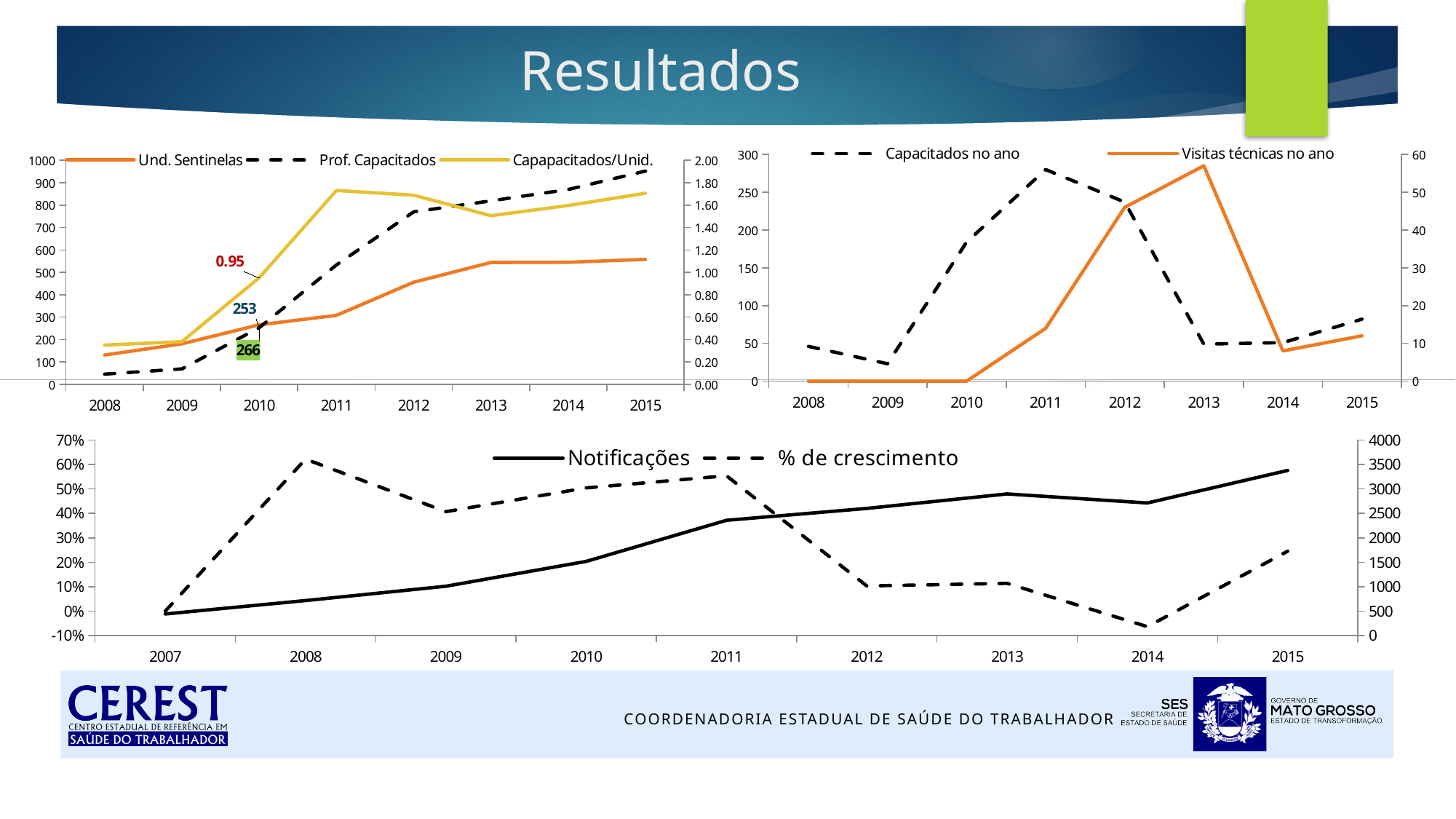
How many series does the legend of the top-left chart list? 3 How many years are shown on the x axis of the bottom chart? 9 In the top-right chart, in which year does Capacitados no ano reach its highest value? 2011 How many series does the legend of the top-right chart list? 2 In the top-right chart, in which year does Visitas técnicas no ano reach its highest value? 2013 In the top-left chart, what value is labelled for Capapacitados/Unid. in 2010? 0.95 How many years are shown on the x axis of the top-right chart? 8 In the top-left chart, is the value for Und. Sentinelas in 2015 greater or less than 500 on the left axis? greater In the bottom chart, in which year is % de crescimento at its lowest? 2014 What kind of chart is the top-left chart on the slide? Line chart In the top-right chart, is the value for Capacitados no ano in 2011 greater or less than 250? greater In the bottom chart, does the Notificações line rise or fall from 2007 to 2015? Rise